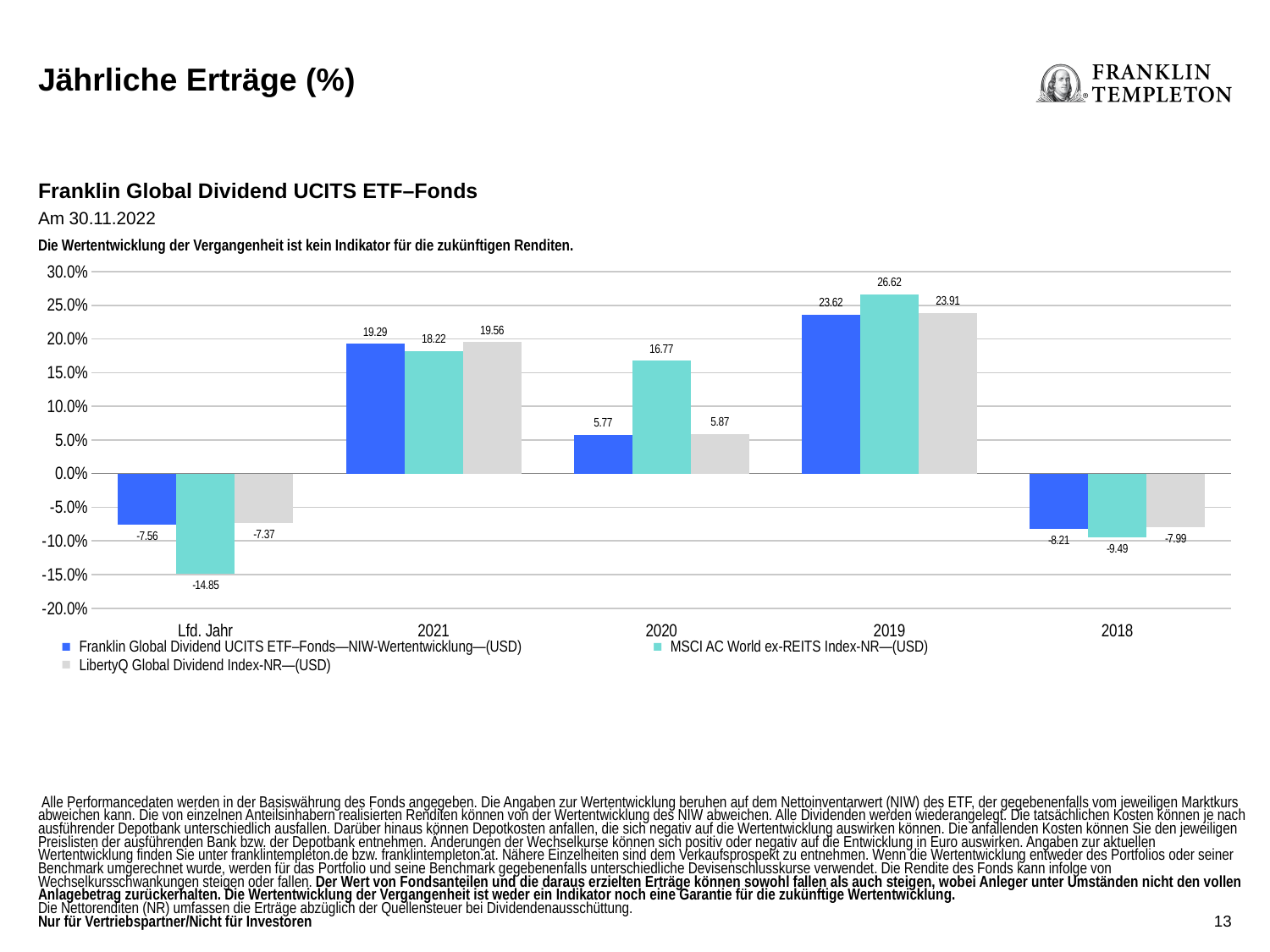
What is the title of the slide containing the chart? Jährliche Erträge (%) What is the value for the Franklin Global Dividend UCITS ETF–Fonds—NIW-Wertentwicklung—(USD) series in 2021? 19.29 What is the value for the LibertyQ Global Dividend Index-NR—(USD) series in 2018? -7.99 In which year does the MSCI AC World ex-REITS Index-NR—(USD) series reach its highest value? 2019 What is the difference between the MSCI AC World ex-REITS Index-NR—(USD) value and the Franklin Global Dividend UCITS ETF–Fonds value in 2020? 11.00 What kind of chart is shown on the slide? Bar chart What is the value for the MSCI AC World ex-REITS Index-NR—(USD) series for Lfd. Jahr? -14.85 What is the value for the MSCI AC World ex-REITS Index-NR—(USD) series in 2020? 16.77 How many categories are shown on the x axis of the chart? 5 Which category has the lowest value for the Franklin Global Dividend UCITS ETF–Fonds—NIW-Wertentwicklung—(USD) series? 2018 In 2019, which is larger: the Franklin Global Dividend UCITS ETF–Fonds value or the MSCI AC World ex-REITS Index-NR—(USD) value? MSCI AC World ex-REITS Index-NR—(USD) How many series does the legend list? 3